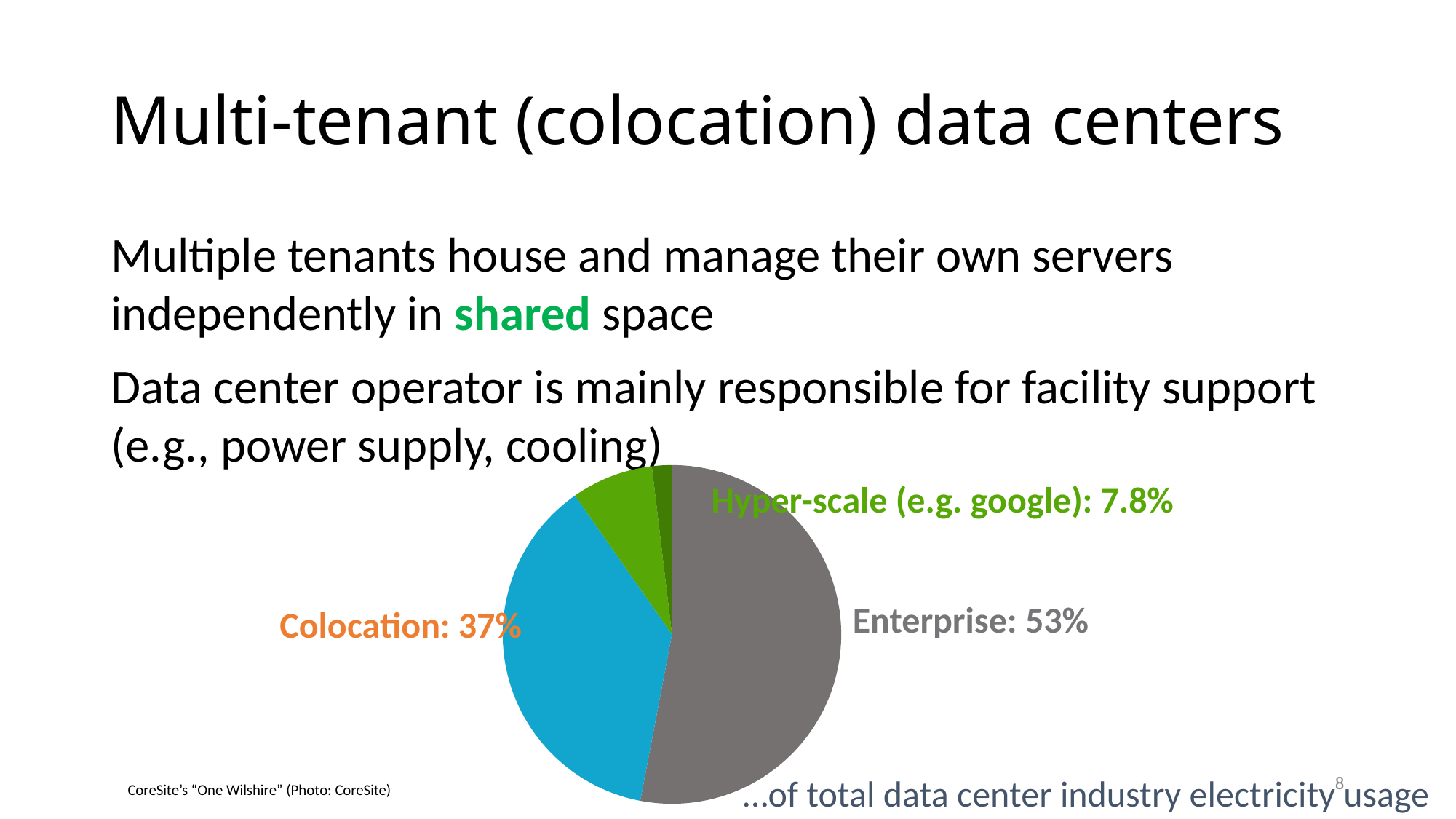
Which category has the largest share of the pie chart? Enterprise Is the Enterprise share in the pie chart greater or less than 50%? greater How many percentage points larger is the Colocation share than the Hyper-scale share? 29.2 Of the labeled categories in the pie chart, which has the smallest share? Hyper-scale (e.g. google) How many slices of the pie chart have a printed label with a percentage? 3 What colour is the Colocation slice in the pie chart? blue What share does Colocation have in the pie chart? 37% What share does Hyper-scale (e.g. google) have in the pie chart? 7.8% Which is larger in the pie chart, the Colocation share or the Enterprise share? Enterprise What share of total data center industry electricity usage does Enterprise account for in the pie chart? 53% What kind of chart is shown on the slide? pie chart How many percentage points larger is the Enterprise share than the Colocation share? 16